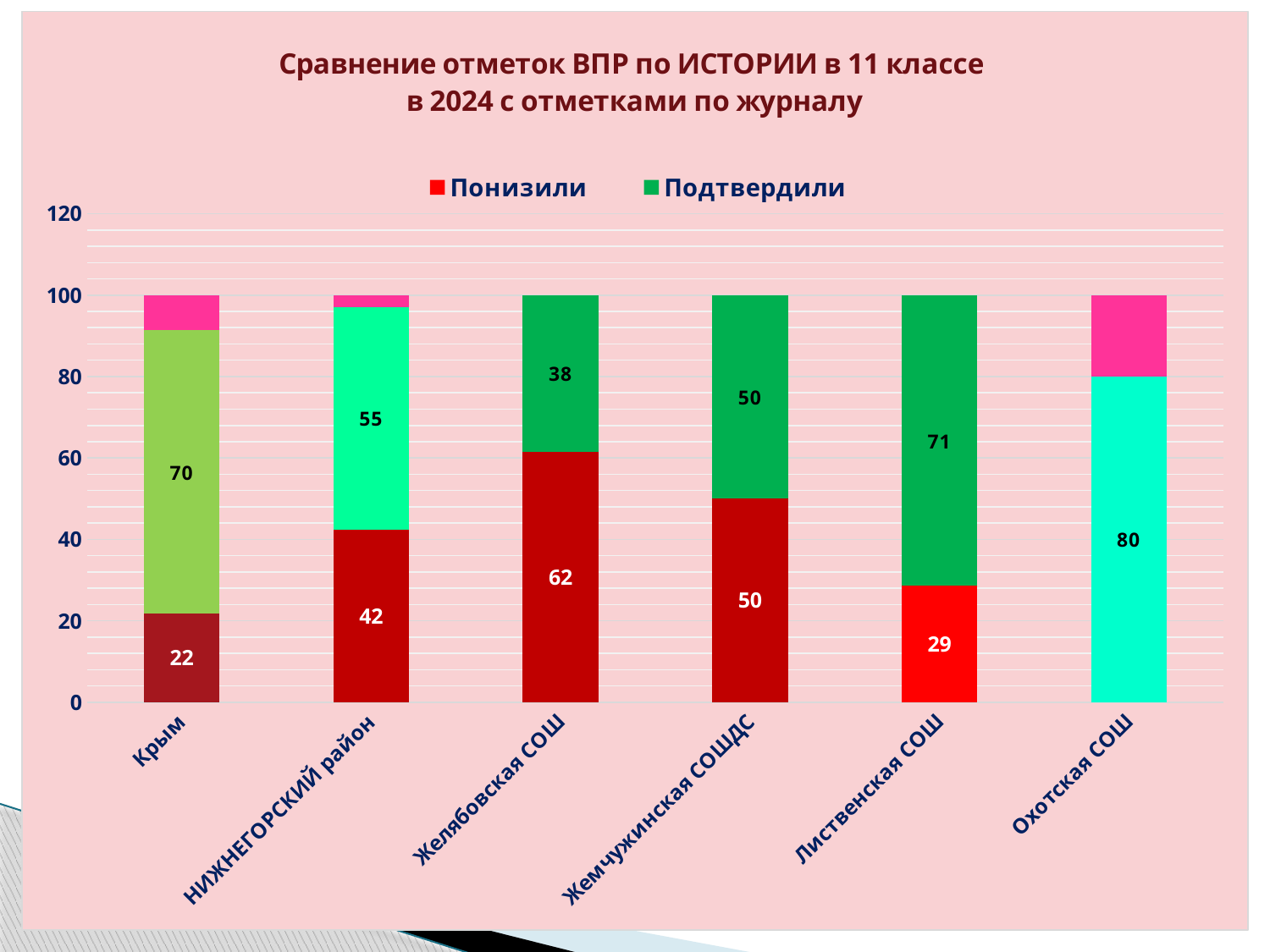
Which is larger: the Понизили value for НИЖНЕГОРСКИЙ район or the Понизили value for Лиственская СОШ? НИЖНЕГОРСКИЙ район What is the Подтвердили value for Охотская СОШ? 80 What is the difference between the Подтвердили and Понизили values for Лиственская СОШ? 42 What is the Подтвердили value for Лиственская СОШ? 71 Which category has the highest Понизили value? Желябовская СОШ What kind of chart is shown on the slide? Stacked bar chart How many series does the legend list? 2 What is the total of the Понизили and Подтвердили segments for Жемчужинская СОШДС? 100 What is the Понизили value for Крым? 22 Which category has the lowest Подтвердили value? Желябовская СОШ How many categories are shown on the x axis? 6 What is the Понизили value for Желябовская СОШ? 62